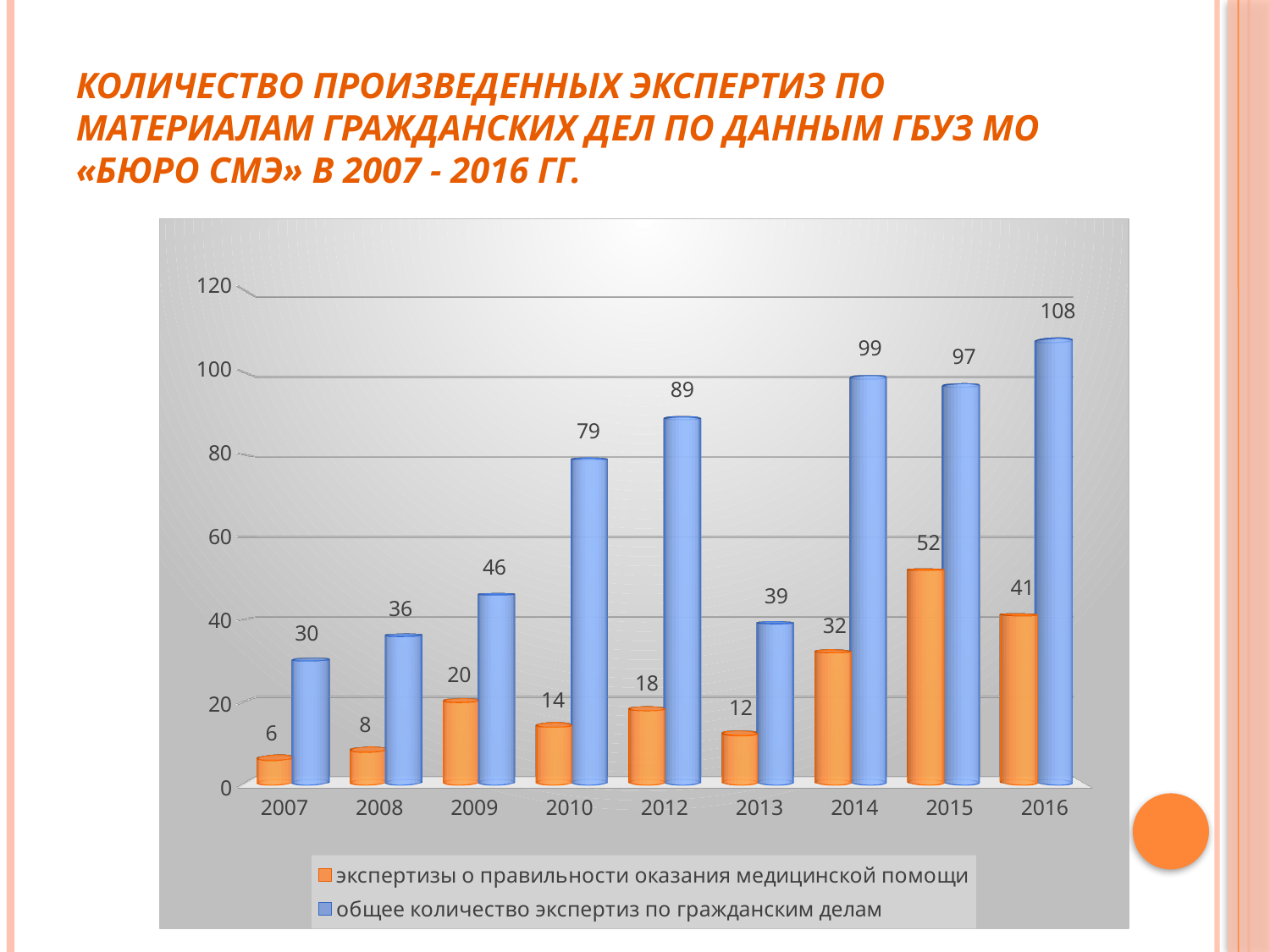
Which year has the lowest value for 'экспертизы о правильности оказания медицинской помощи'? 2007 How many years are shown on the x axis? 9 What kind of chart is shown on the slide? bar chart What is the value for 'общее количество экспертиз по гражданским делам' in 2016? 108 What is the value for 'экспертизы о правильности оказания медицинской помощи' in 2015? 52 Does the value for 'общее количество экспертиз по гражданским делам' rise or fall from 2007 to 2012? rise What is the value for 'общее количество экспертиз по гражданским делам' in 2010? 79 Which colour represents 'экспертизы о правильности оказания медицинской помощи'? orange How many series does the legend list? 2 What is the difference between the two series in 2014? 67 Which year has the highest value for 'общее количество экспертиз по гражданским делам'? 2016 Which is larger: 'общее количество экспертиз по гражданским делам' in 2012 or in 2013? 2012